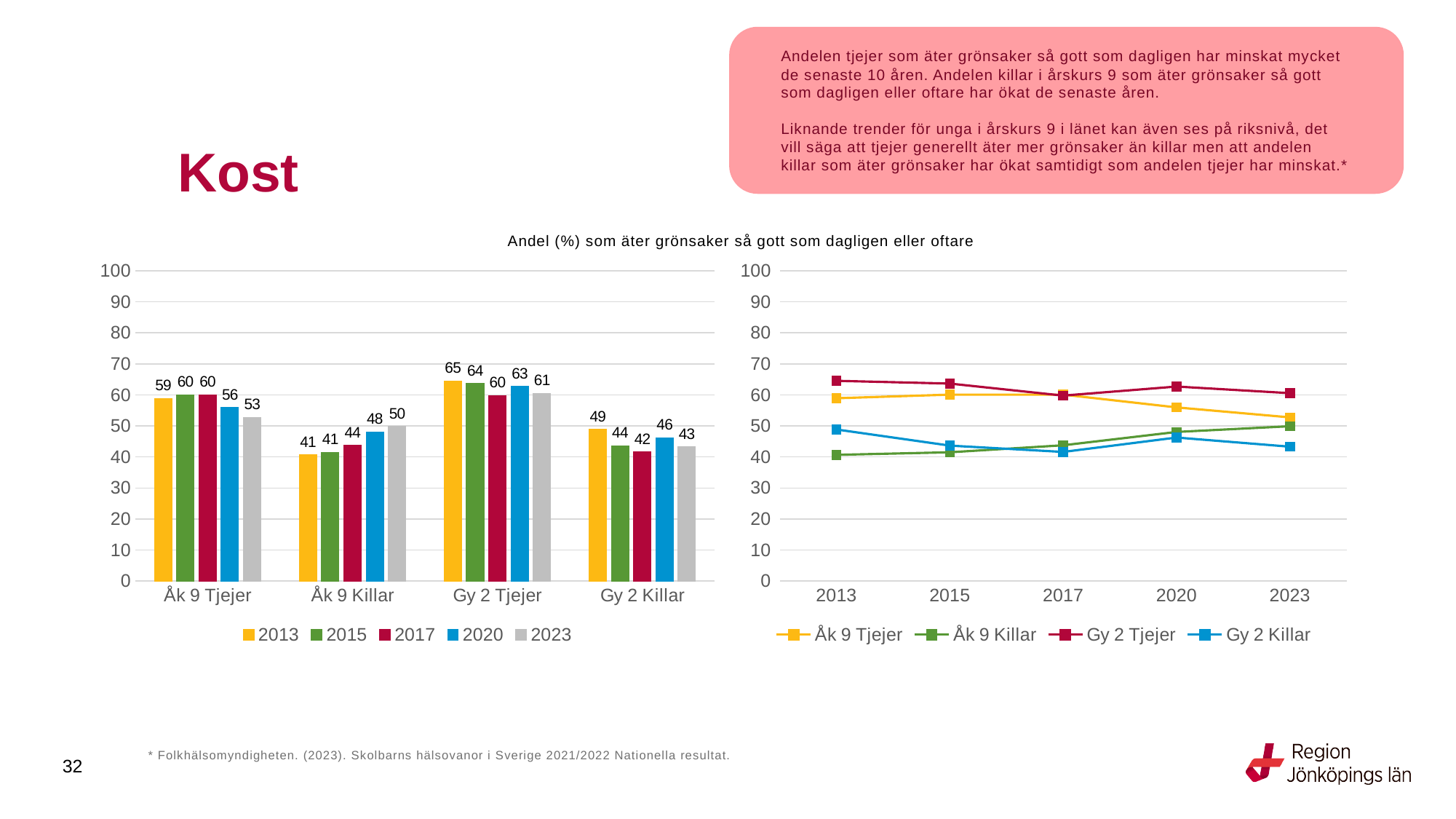
In the bar chart on the left, which is larger in 2023: Åk 9 Tjejer or Gy 2 Killar? Åk 9 Tjejer What is the title shown above the charts? Andel (%) som äter grönsaker så gott som dagligen eller oftare In the line chart on the right, does the value for Åk 9 Killar rise or fall from 2013 to 2023? rise What kind of chart is the chart on the right? line chart In the line chart on the right, is the value for Gy 2 Tjejer in 2013 greater or less than 60? greater How many categories are shown on the x axis of the bar chart on the left? 4 In the bar chart on the left, which year has the lowest value for Gy 2 Killar? 2017 In the bar chart on the left, what is the difference between the 2013 values for Gy 2 Tjejer and Åk 9 Killar? 24 How many series does the legend of the bar chart on the left list? 5 In the bar chart on the left, which year has the highest value for Åk 9 Killar? 2023 In the bar chart on the left, what is the value for Åk 9 Tjejer in 2013? 59 In the bar chart on the left, what is the value for Gy 2 Killar in 2020? 46